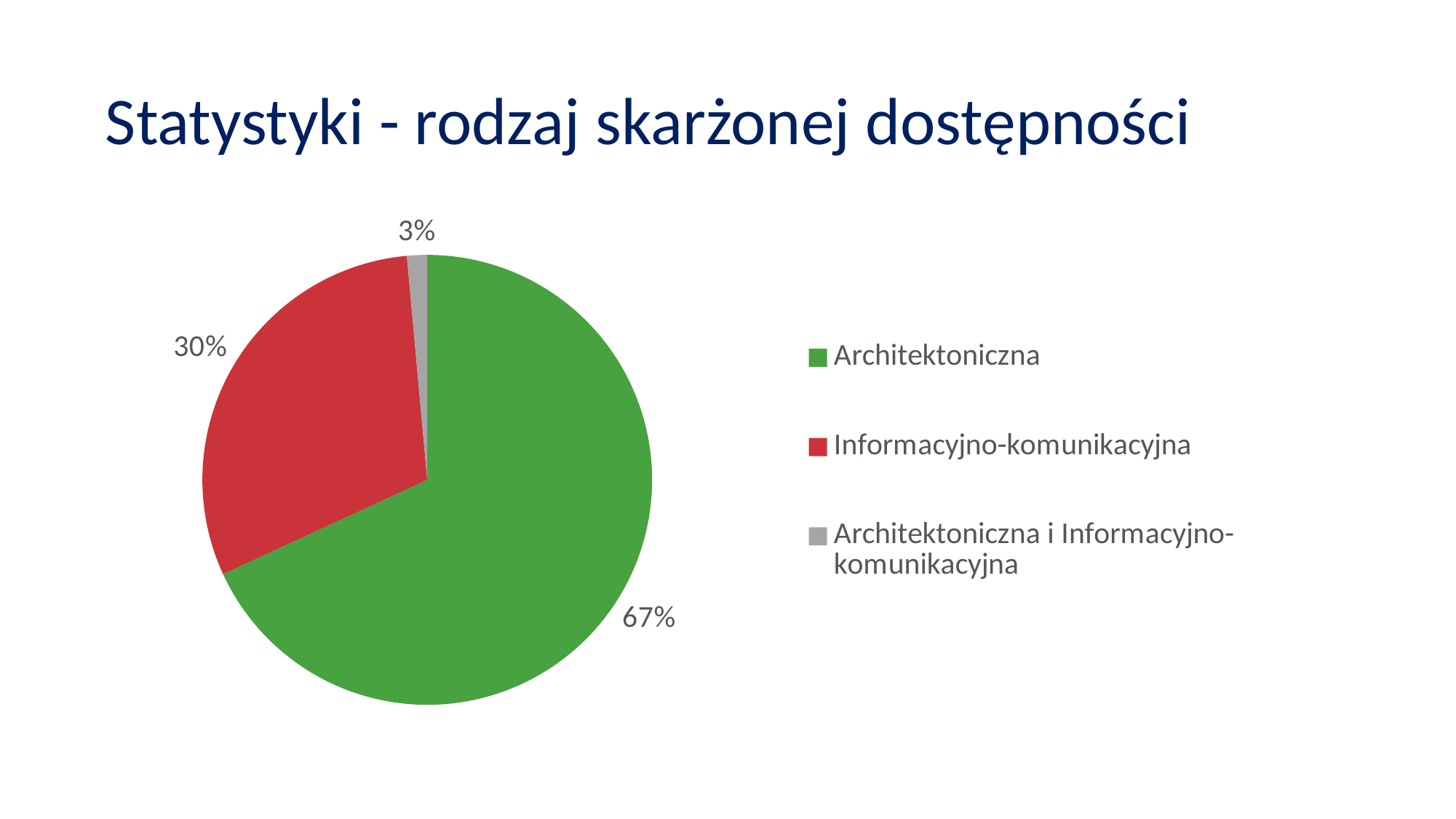
Which category has the smallest slice of the pie? Architektoniczna i Informacyjno-komunikacyjna What is the difference in percentage points between Architektoniczna and Informacyjno-komunikacyjna? 37 What is the title of the slide? Statystyki - rodzaj skarżonej dostępności What is the combined share of Informacyjno-komunikacyjna and Architektoniczna i Informacyjno-komunikacyjna? 33% What kind of chart is shown on the slide? Pie chart Which is larger, the slice for Informacyjno-komunikacyjna or the slice for Architektoniczna i Informacyjno-komunikacyjna? Informacyjno-komunikacyjna What share of the pie does Architektoniczna have? 67% What share of the pie does Informacyjno-komunikacyjna have? 30% What colour is the slice for Informacyjno-komunikacyjna? Red What share of the pie does Architektoniczna i Informacyjno-komunikacyjna have? 3% How many categories does the pie chart show? 3 Which category has the largest slice of the pie? Architektoniczna